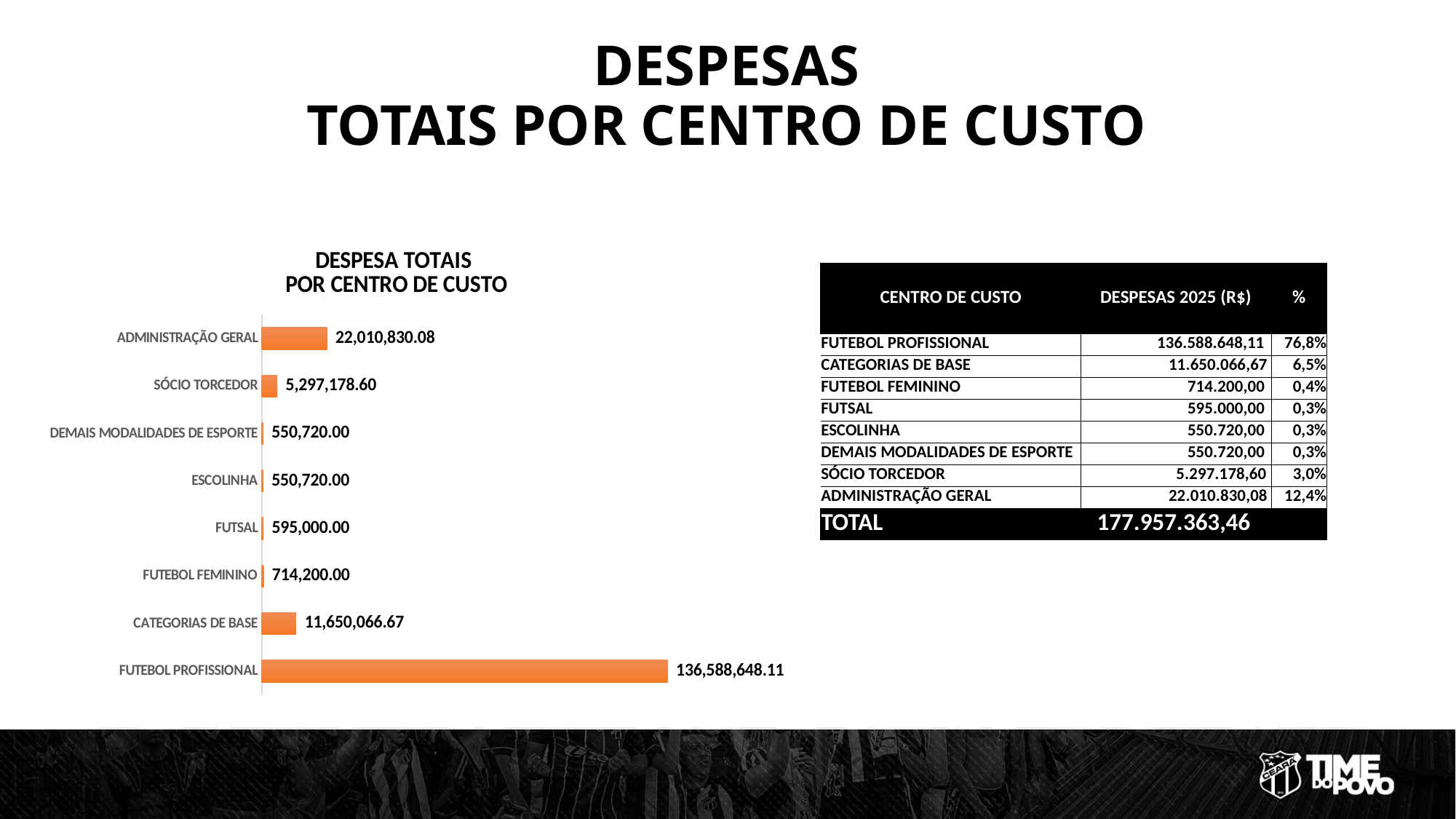
What is the value for FUTEBOL FEMININO in the chart? 714,200.00 Which is larger in the chart, ADMINISTRAÇÃO GERAL or CATEGORIAS DE BASE? ADMINISTRAÇÃO GERAL What is the value for CATEGORIAS DE BASE in the chart? 11,650,066.67 What is the difference between the values for FUTEBOL FEMININO and FUTSAL in the chart? 119,200.00 How many categories are shown in the chart? 8 What is the value for SÓCIO TORCEDOR in the chart? 5,297,178.60 What type of chart is shown on the slide? Bar chart What is the value for ADMINISTRAÇÃO GERAL in the chart? 22,010,830.08 What is the difference between the values for FUTSAL and ESCOLINHA in the chart? 44,280.00 What is the title of the chart? DESPESA TOTAIS POR CENTRO DE CUSTO What is the value for FUTEBOL PROFISSIONAL in the chart? 136,588,648.11 Which category has the highest value in the chart? FUTEBOL PROFISSIONAL